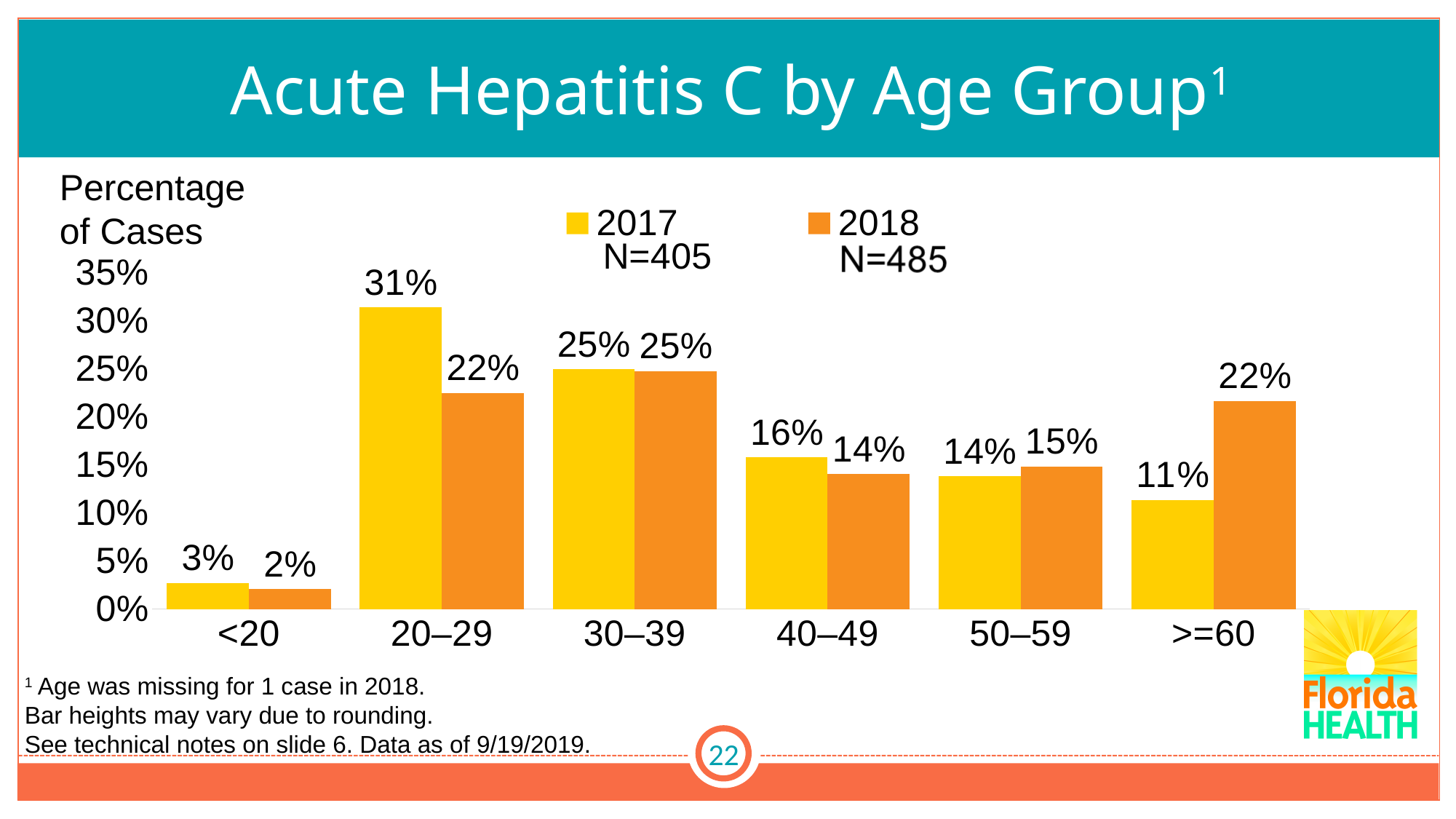
What kind of chart is shown on the slide? Bar chart What percentage of cases were in the 20–29 age group in 2017? 31% How many series does the legend list? 2 What percentage of cases were in the >=60 age group in 2018? 22% What is the N value shown in the legend for 2018? N=485 How many age groups are shown on the x axis? 6 Which age group had the highest percentage of cases in 2017? 20–29 Which year had the larger percentage of cases in the >=60 age group, 2017 or 2018? 2018 What percentage of cases were in the <20 age group in 2018? 2% What is the difference between the 2017 and 2018 percentages for the 20–29 age group? 9% What is the difference between the 2017 and 2018 percentages for the >=60 age group? 11% Which age group had the lowest percentage of cases in 2018? <20